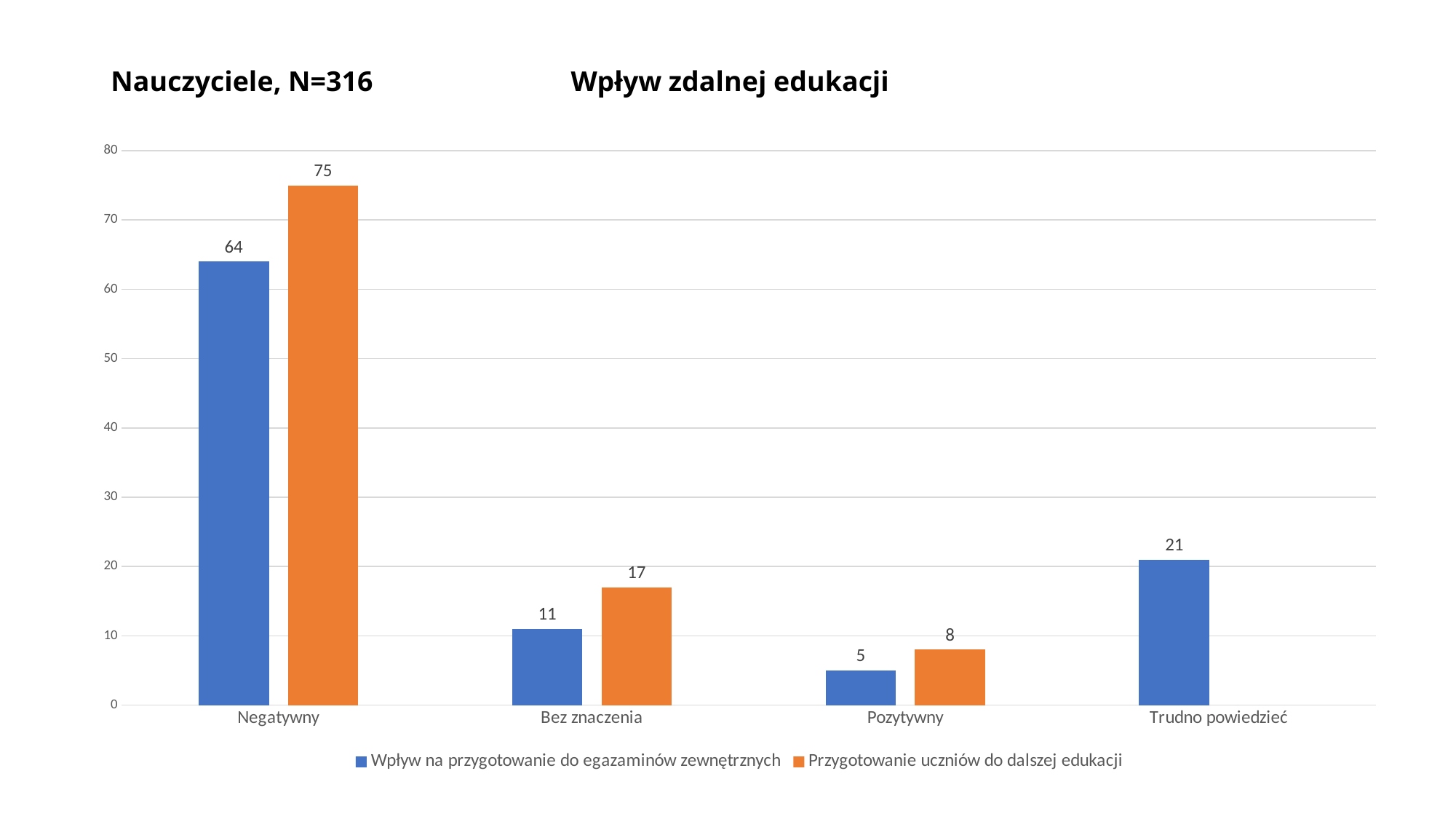
For 'Pozytywny', which series has the larger value? Przygotowanie uczniów do dalszej edukacji How many categories are shown on the x axis? 4 Which category has the highest value in the 'Przygotowanie uczniów do dalszej edukacji' series? Negatywny Which category has the lowest value in the 'Wpływ na przygotowanie do egazaminów zewnętrznych' series? Pozytywny What is the value for 'Trudno powiedzieć' in the 'Wpływ na przygotowanie do egazaminów zewnętrznych' series? 21 What is the value for 'Bez znaczenia' in the 'Przygotowanie uczniów do dalszej edukacji' series? 17 Is the value for 'Negatywny' in the 'Przygotowanie uczniów do dalszej edukacji' series greater or less than 70? greater What kind of chart is shown on the slide? bar chart How many series does the legend list? 2 What is the difference between the two series' values for 'Negatywny'? 11 What is the title of the chart? Wpływ zdalnej edukacji What is the value for 'Negatywny' in the 'Wpływ na przygotowanie do egazaminów zewnętrznych' series? 64